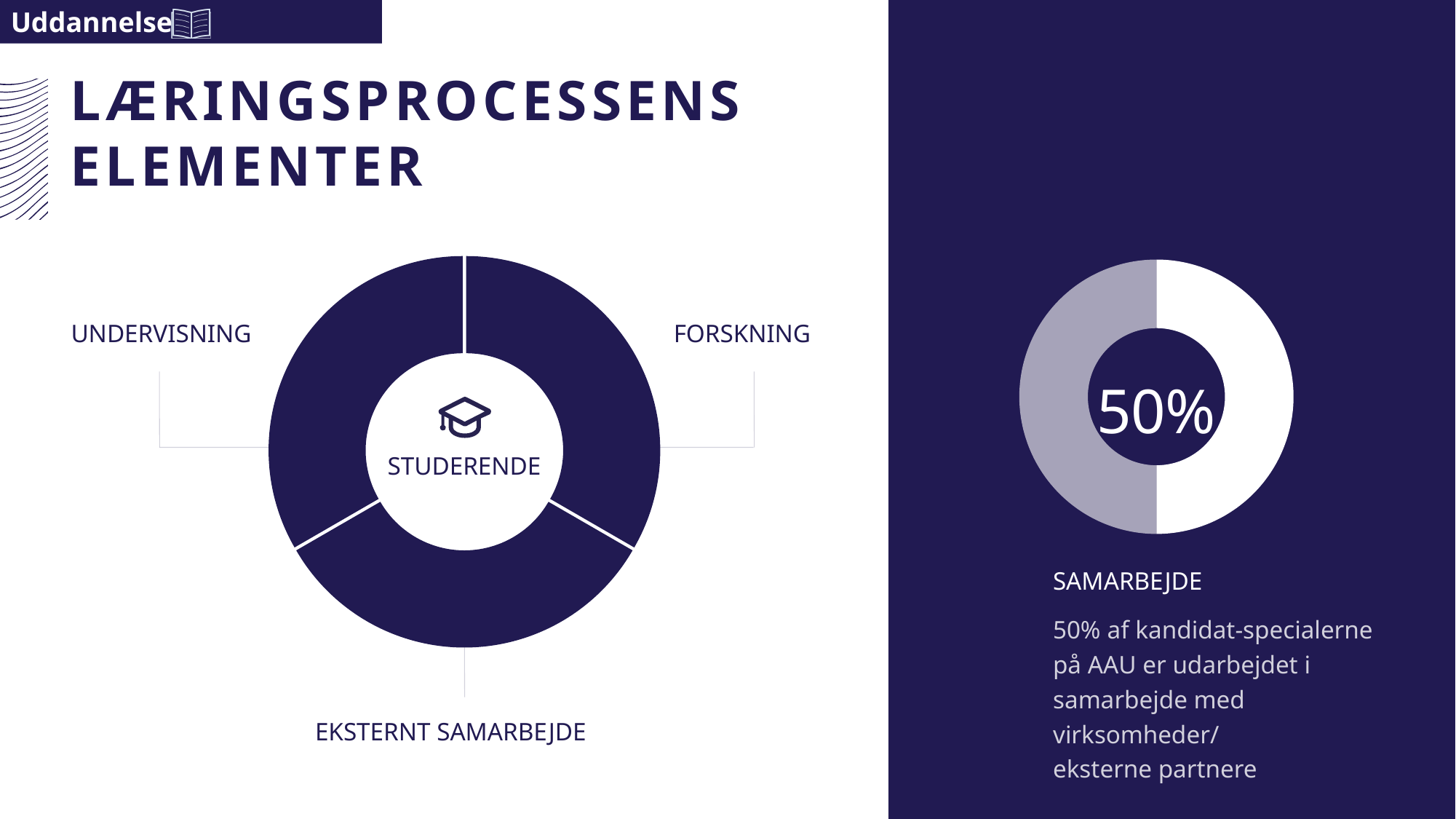
On the left-hand donut diagram, which label is attached to the bottom segment? EKSTERNT SAMARBEJDE On the left-hand donut diagram, what label is in the centre of the ring? STUDERENDE On the right-hand chart, what percentage is printed in the centre of the donut? 50% On the right-hand chart, is the share for SAMARBEJDE greater or less than 25%? greater On the right-hand chart, what label appears directly below the donut? SAMARBEJDE On the left-hand donut diagram, which label is attached to the segment on the right? FORSKNING What is the title of the slide containing the charts? LÆRINGSPROCESSENS ELEMENTER On the left-hand donut diagram, which label is attached to the segment on the left? UNDERVISNING On the right-hand chart, what share of the donut does the grey segment represent? 50% On the right-hand chart, how many segments does the donut have? 2 On the left-hand donut diagram, how many segments surround the centre? 3 What kind of chart is shown on the right-hand side of the slide? Donut (pie) chart